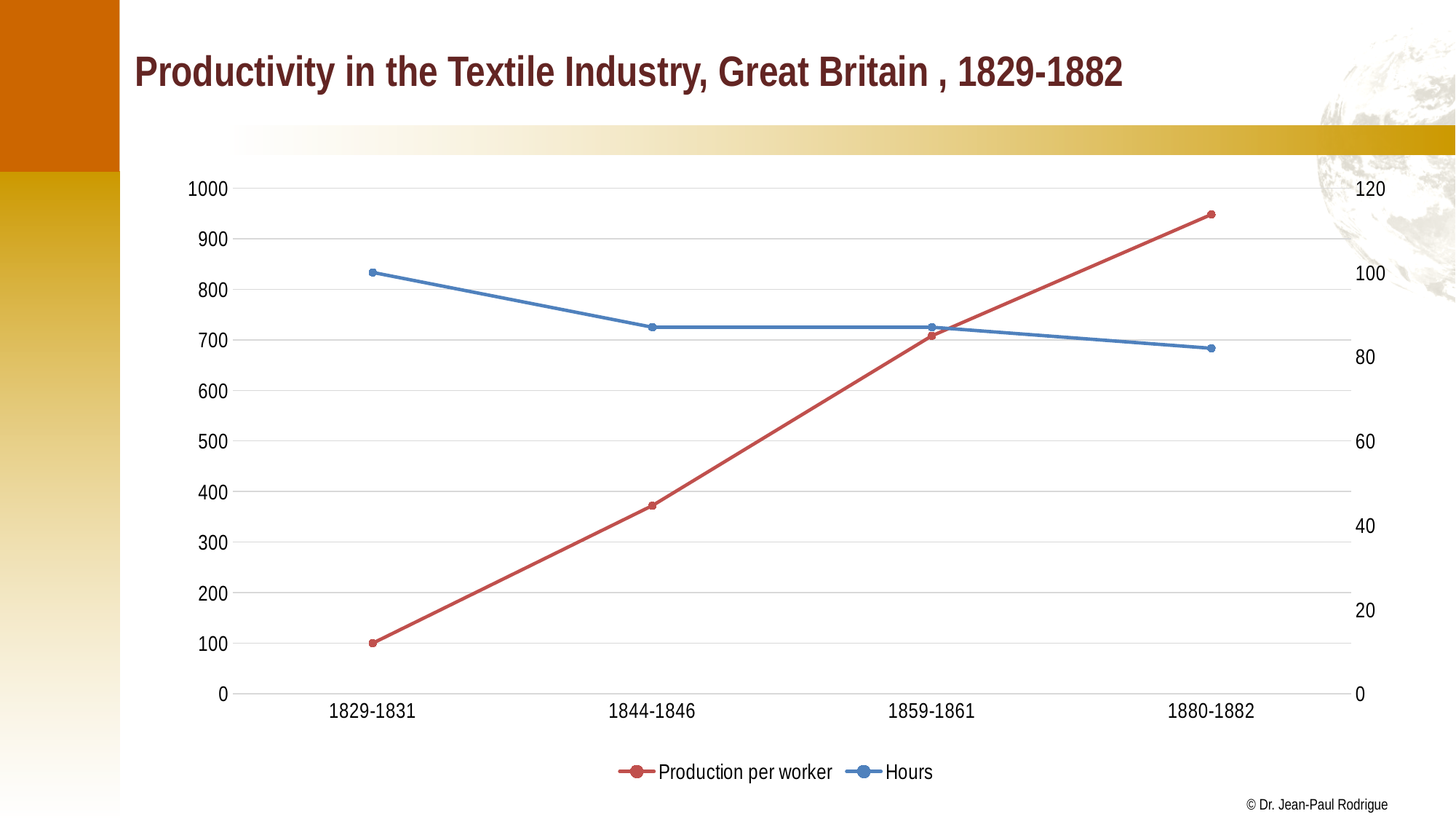
Which colour is used for the Hours series? Blue Is the value for Hours in 1880-1882 greater or less than 100 on the right axis? less What kind of chart is shown on the slide? Line chart What is the value of Production per worker for 1829-1831? 100 How many time periods are shown on the x axis? 4 In which period is Production per worker highest? 1880-1882 Is the value for Production per worker in 1844-1846 greater or less than 400? less Is the value for Production per worker in 1880-1882 greater or less than 900? greater How many series does the legend list? 2 Does Production per worker rise or fall from 1829-1831 to 1880-1882? Rise In which period is Hours lowest? 1880-1882 In which period is Hours highest? 1829-1831